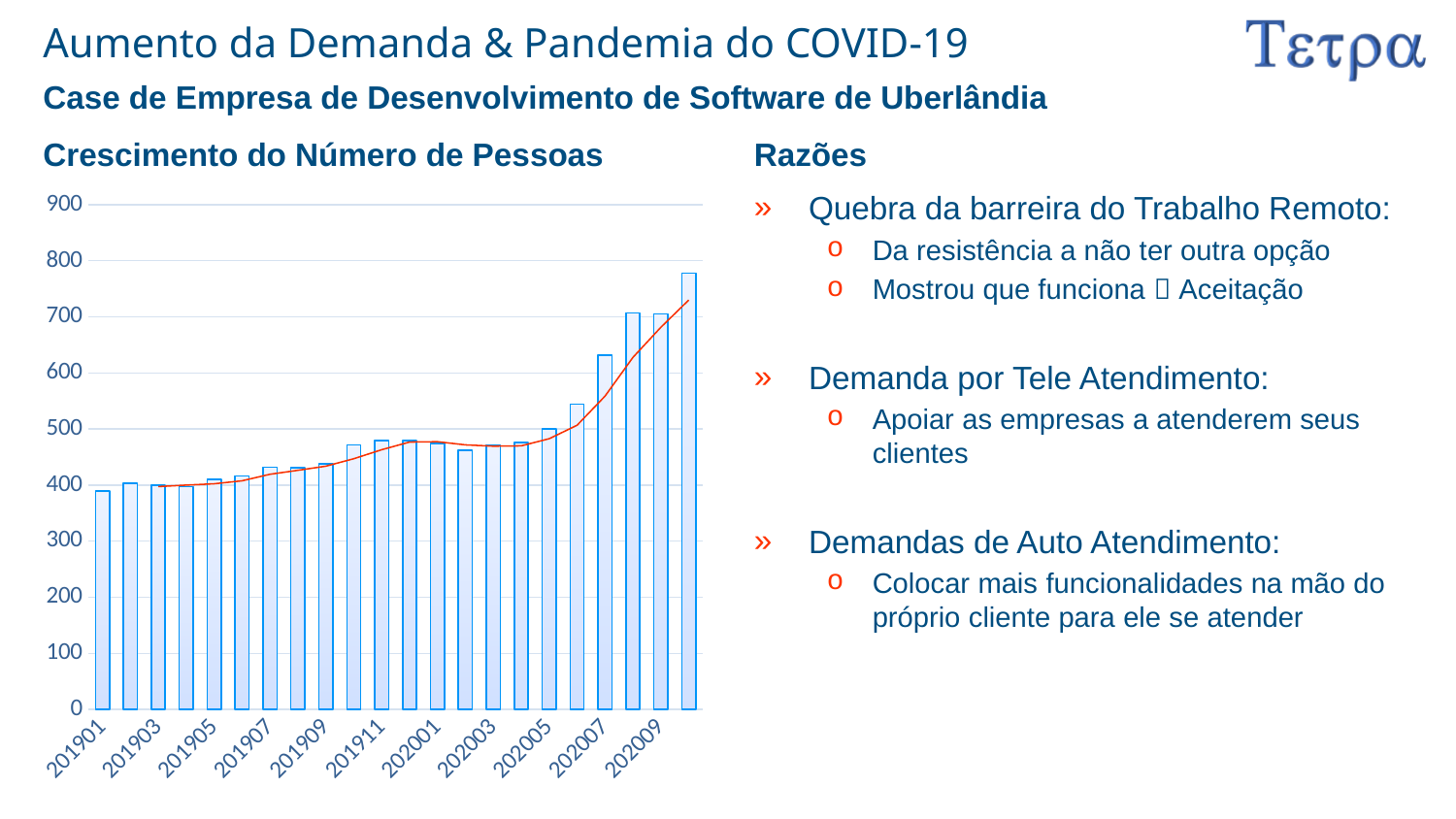
Is the value for 201907 greater or less than 400? greater Which is larger, the value for 202007 or the value for 201901? 202007 Which is larger, the value for 202003 or the value for 202009? 202009 Do the values in the chart generally rise or fall from 201901 to 202009? rise What is the highest value shown on the vertical axis of the chart? 900 Is the value for 202007 greater or less than 600? greater What is the title of the chart on the slide? Crescimento do Número de Pessoas Is the value for 202003 greater or less than 500? less How many bars are plotted in the chart? 22 What kind of chart is shown on the slide? bar chart